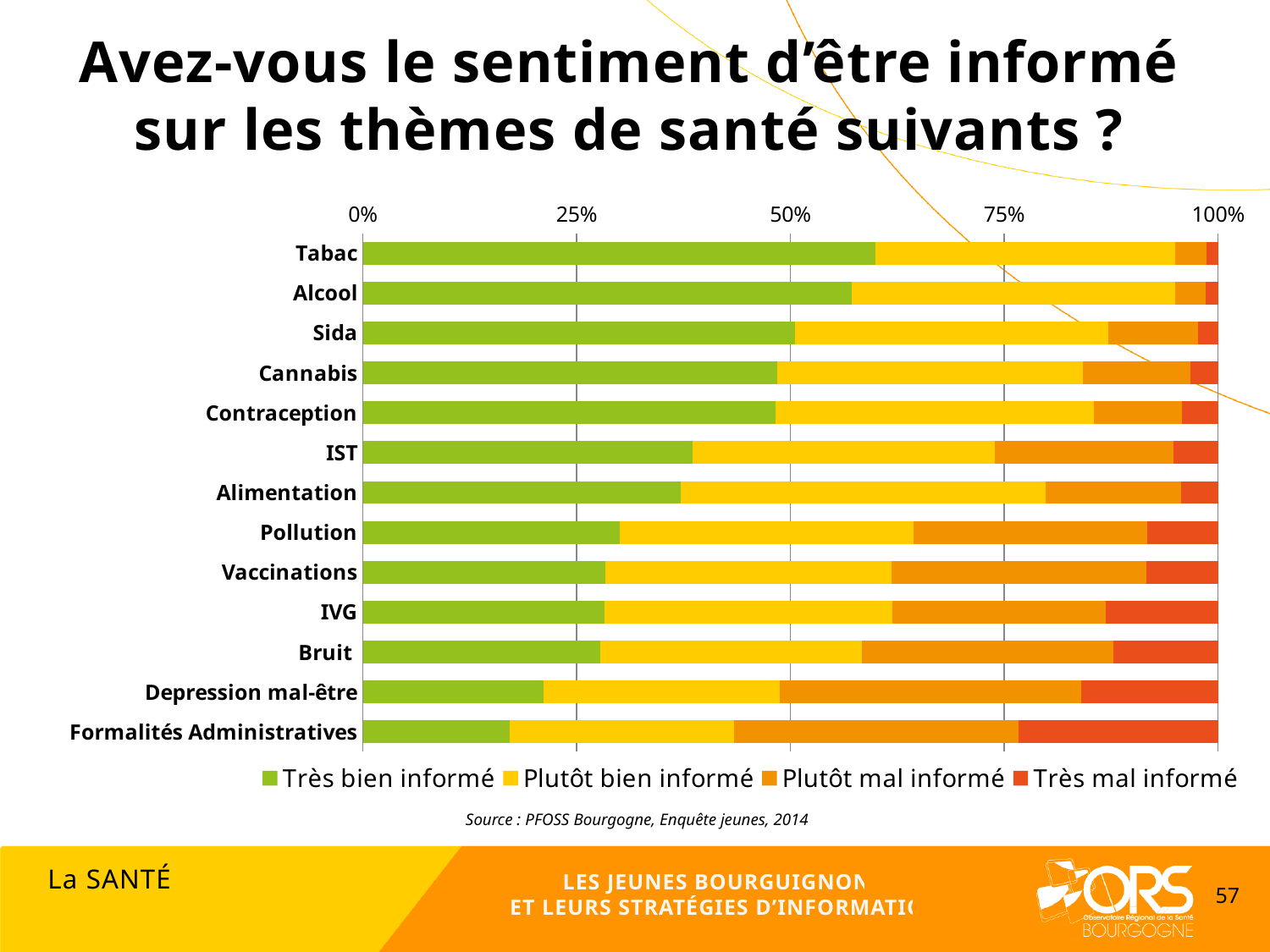
Is the 'Très bien informé' share for Formalités Administratives greater or less than 25%? less Which theme has the largest 'Très bien informé' share? Tabac Which legend entry is shown in green? Très bien informé What kind of chart is shown on the slide? stacked bar chart How many health themes (categories) are listed on the chart? 13 Is the 'Très bien informé' share for Tabac greater or less than 50%? greater Which theme has the smallest 'Très bien informé' share? Formalités Administratives Going down the list of themes from Tabac to Formalités Administratives, does the 'Très bien informé' share rise or fall? fall Which has a larger 'Très bien informé' share, Tabac or Formalités Administratives? Tabac Is the 'Très bien informé' share for IST greater or less than 50%? less How many series does the legend list? 4 Which theme has the largest 'Très mal informé' share? Formalités Administratives